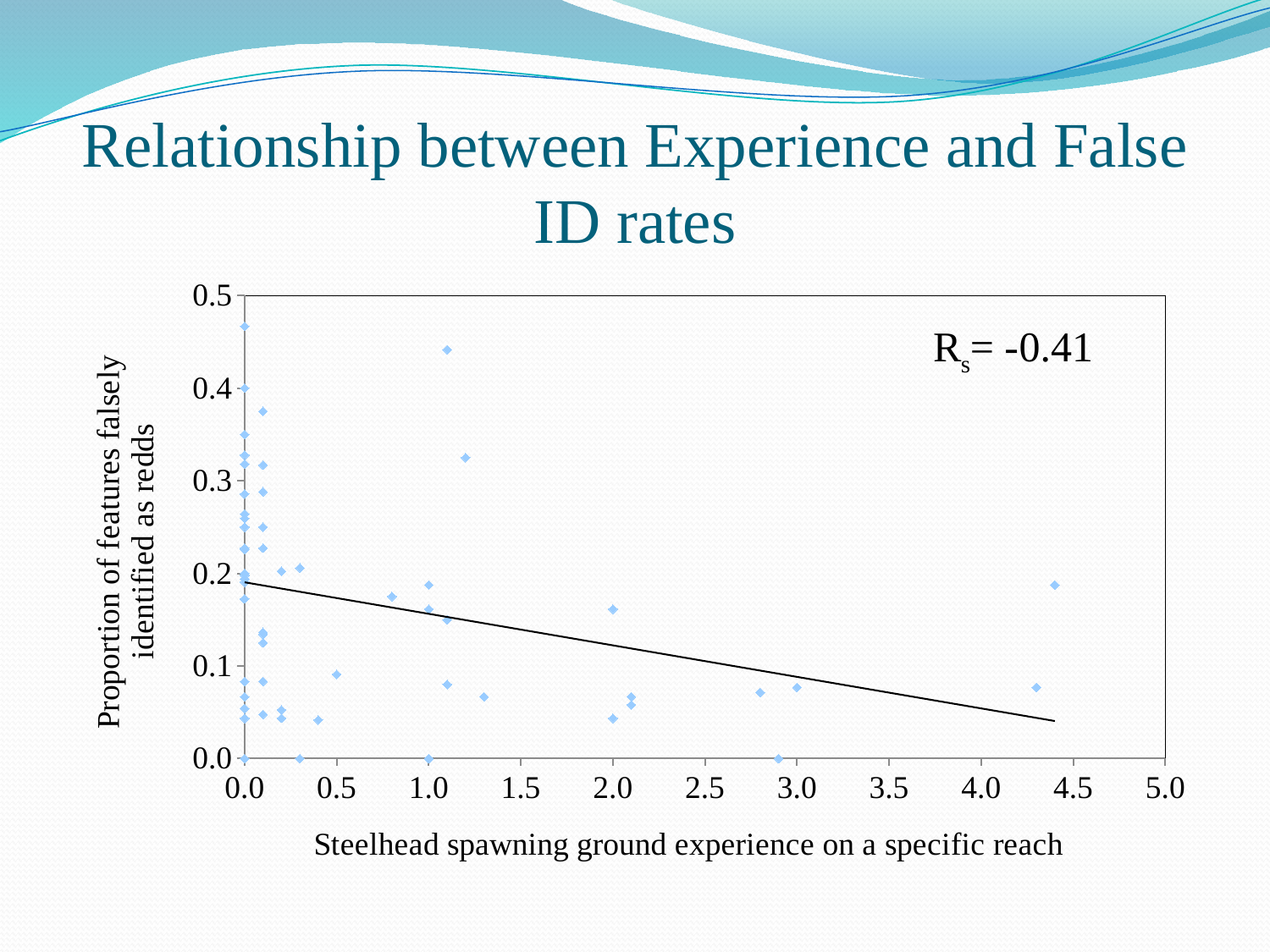
What is the label of the x axis? Steelhead spawning ground experience on a specific reach Is the proportion for the highest point near 1.1 on the x axis greater or less than 0.4? greater Is the proportion for the point near 1.2 on the x axis (the upper one) greater or less than 0.3? greater Does the fitted line on the chart slope upward or downward from left to right? downward What kind of chart is shown on the slide? scatter plot Do the plotted values generally rise or fall as experience increases along the x axis? fall Is the proportion for the point near 3.0 on the x axis greater or less than 0.1? less What is the value of Rs printed on the chart? -0.41